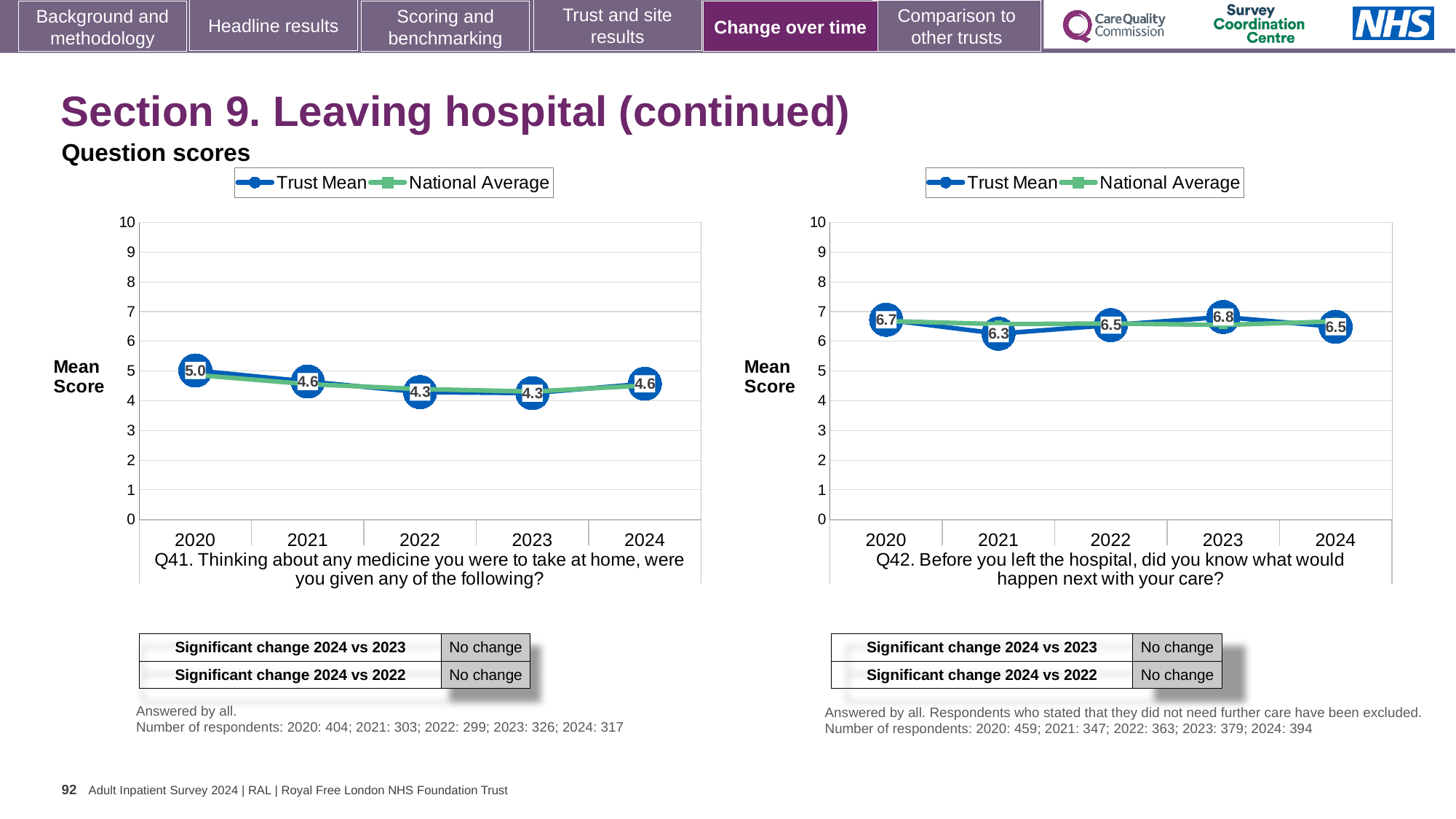
In the Q41 chart (left), what is the Trust Mean score for 2020? 5.0 In the Q41 chart (left), how many years are plotted on the x axis? 5 In the Q42 chart (right), is the Trust Mean score for 2020 larger or smaller than the score for 2024? larger In the Q42 chart (right), what is the Trust Mean score for 2021? 6.3 What kind of chart is the Q42 chart (right)? line chart In the Q41 chart (left), which year has the highest Trust Mean score? 2020 In the Q42 chart (right), is the Trust Mean score for 2022 greater or less than 5? greater How many series does the legend of the Q41 chart (left) list? 2 In the Q41 chart (left), what is the difference between the Trust Mean scores for 2020 and 2022? 0.7 In the Q42 chart (right), which year has the lowest Trust Mean score? 2021 In the Q41 chart (left), what is the Trust Mean score for 2024? 4.6 In the Q42 chart (right), what is the Trust Mean score for 2023? 6.8